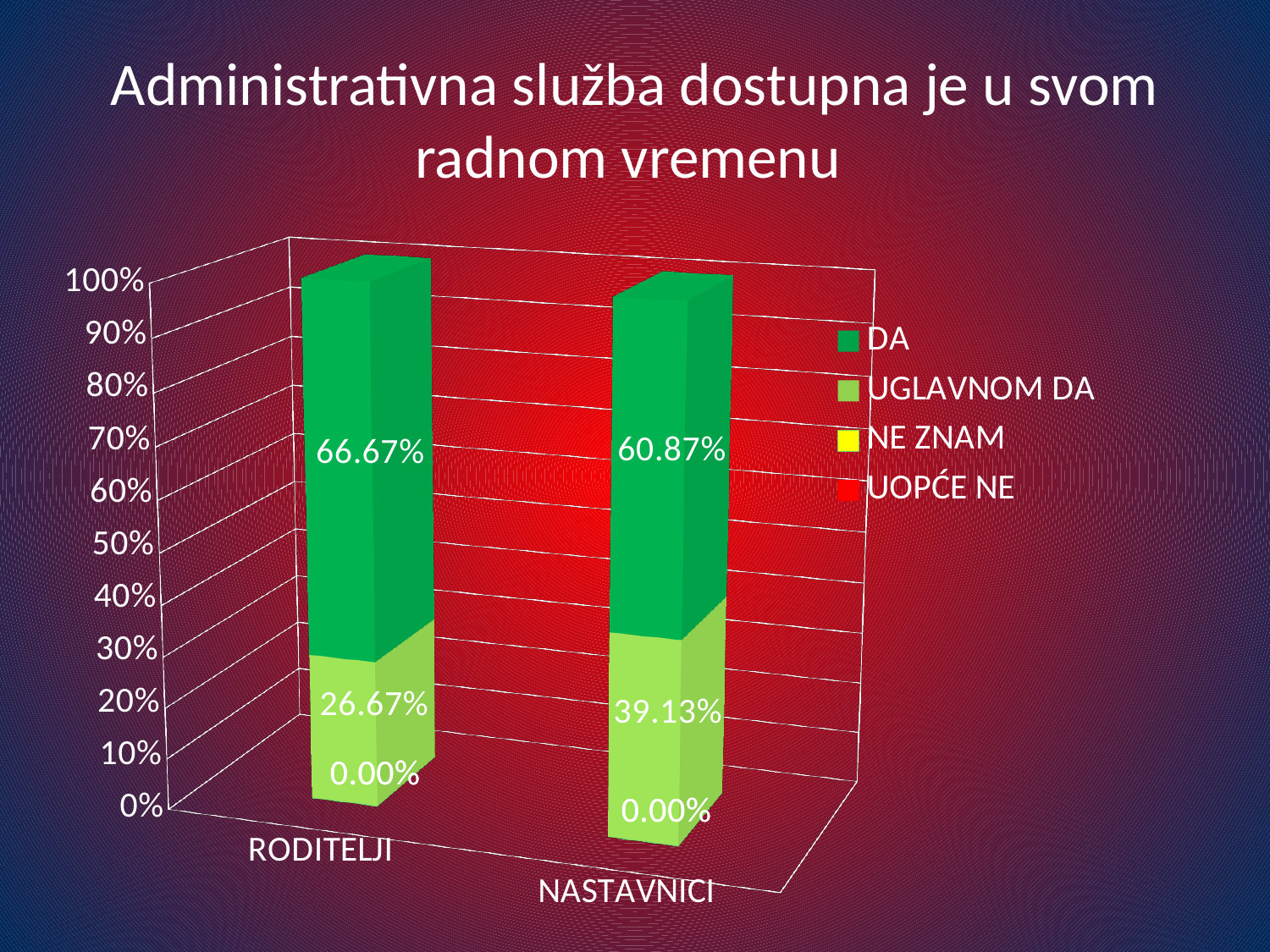
Which group has the higher UGLAVNOM DA value, RODITELJI or NASTAVNICI? NASTAVNICI What is the difference between the UGLAVNOM DA values for NASTAVNICI and RODITELJI? 12.46% What is the difference between the DA values for RODITELJI and NASTAVNICI? 5.80% How many categories are shown on the x axis? 2 What kind of chart is shown on the slide? Stacked bar chart What is the value of DA for RODITELJI? 66.67% Which group has the higher DA value, RODITELJI or NASTAVNICI? RODITELJI What is the value of DA for NASTAVNICI? 60.87% Which legend entry is shown in yellow? NE ZNAM What is the value of UGLAVNOM DA for NASTAVNICI? 39.13% What is the value of UGLAVNOM DA for RODITELJI? 26.67% How many series does the legend list? 4